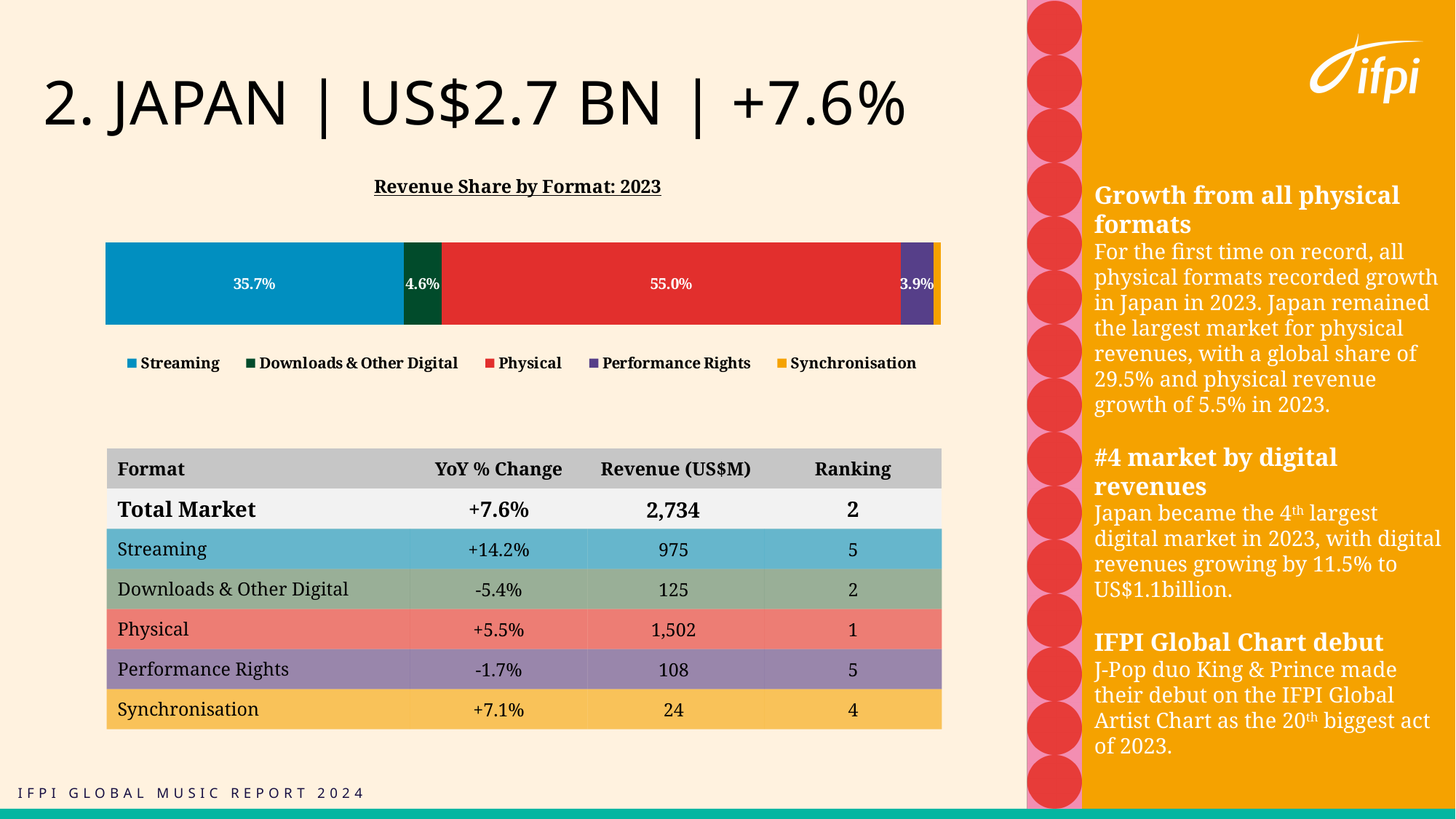
What kind of chart is shown on the slide? Stacked bar chart What is the title of the chart? Revenue Share by Format: 2023 What is the revenue share for Performance Rights in the chart? 3.9% What is the revenue share for Downloads & Other Digital in the chart? 4.6% Which colour represents Physical in the chart? Red What is the revenue share for Physical in the chart? 55.0% What is the difference between the Physical and Streaming revenue shares in the chart? 19.3% What is the revenue share for Streaming in the chart? 35.7% How many series does the chart's legend list? 5 Which format has the largest revenue share in the chart? Physical Which has a larger revenue share in the chart, Downloads & Other Digital or Performance Rights? Downloads & Other Digital Which format has the smallest revenue share in the chart? Synchronisation